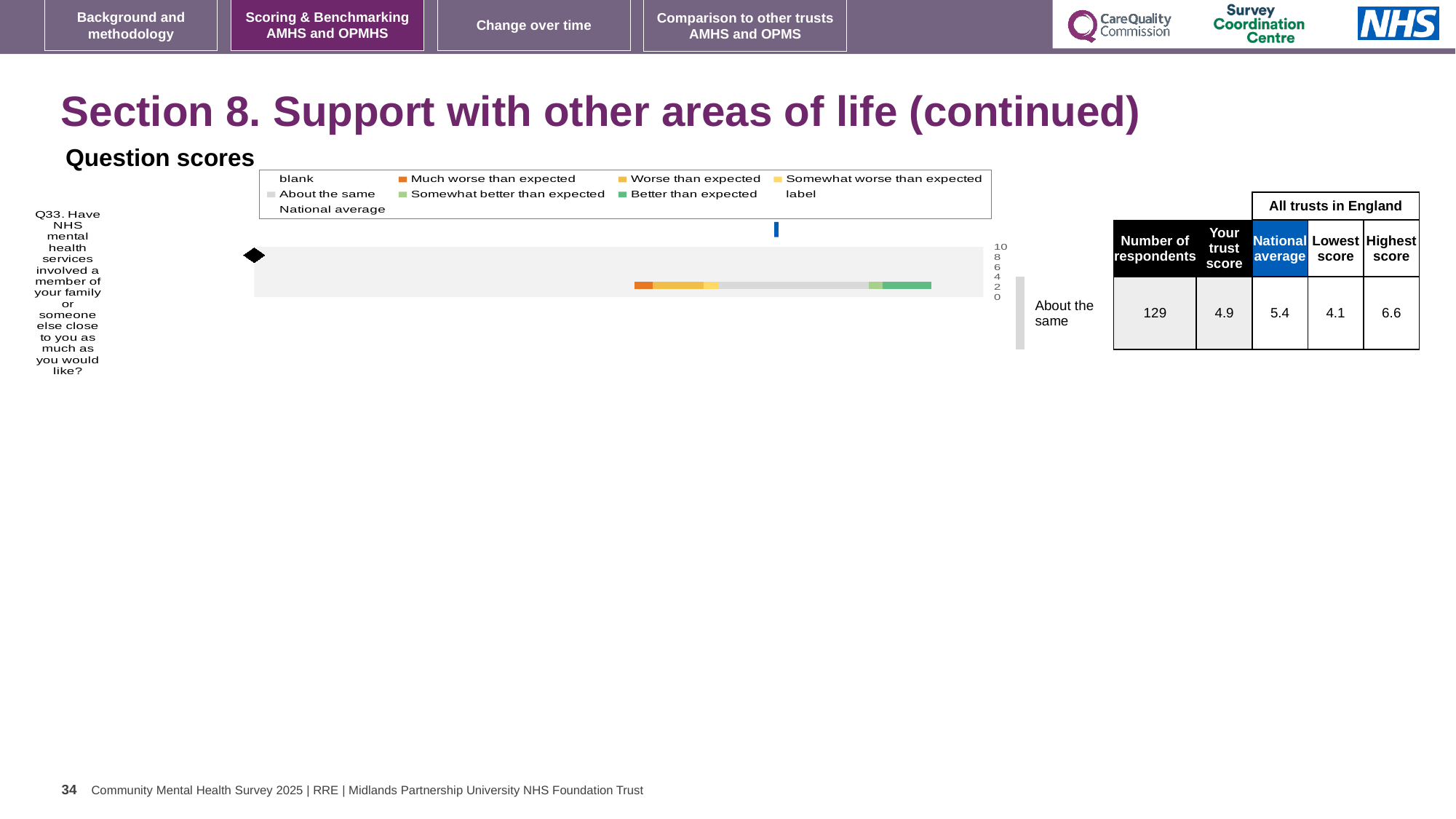
What benchmark category is shown next to the chart for Q33? About the same What is the highest value shown on the axis of the Question scores chart? 10 In the table beside the chart, what is 'Your trust score' for Q33? 4.9 What kind of chart is shown under 'Question scores'? bar chart What is the difference between the highest score (6.6) and the lowest score (4.1) for Q33? 2.5 In the table beside the chart, what is the highest score among all trusts in England for Q33? 6.6 Which is larger for Q33: the trust score or the national average? national average In the table beside the chart, what is the number of respondents for Q33? 129 In the table beside the chart, what is the lowest score among all trusts in England for Q33? 4.1 Which question is plotted in the Question scores chart? Q33. Have NHS mental health services involved a member of your family or someone else close to you as much as you would like? In the table beside the chart, what is the national average for Q33? 5.4 How many questions (categories) are plotted in the Question scores chart? 1